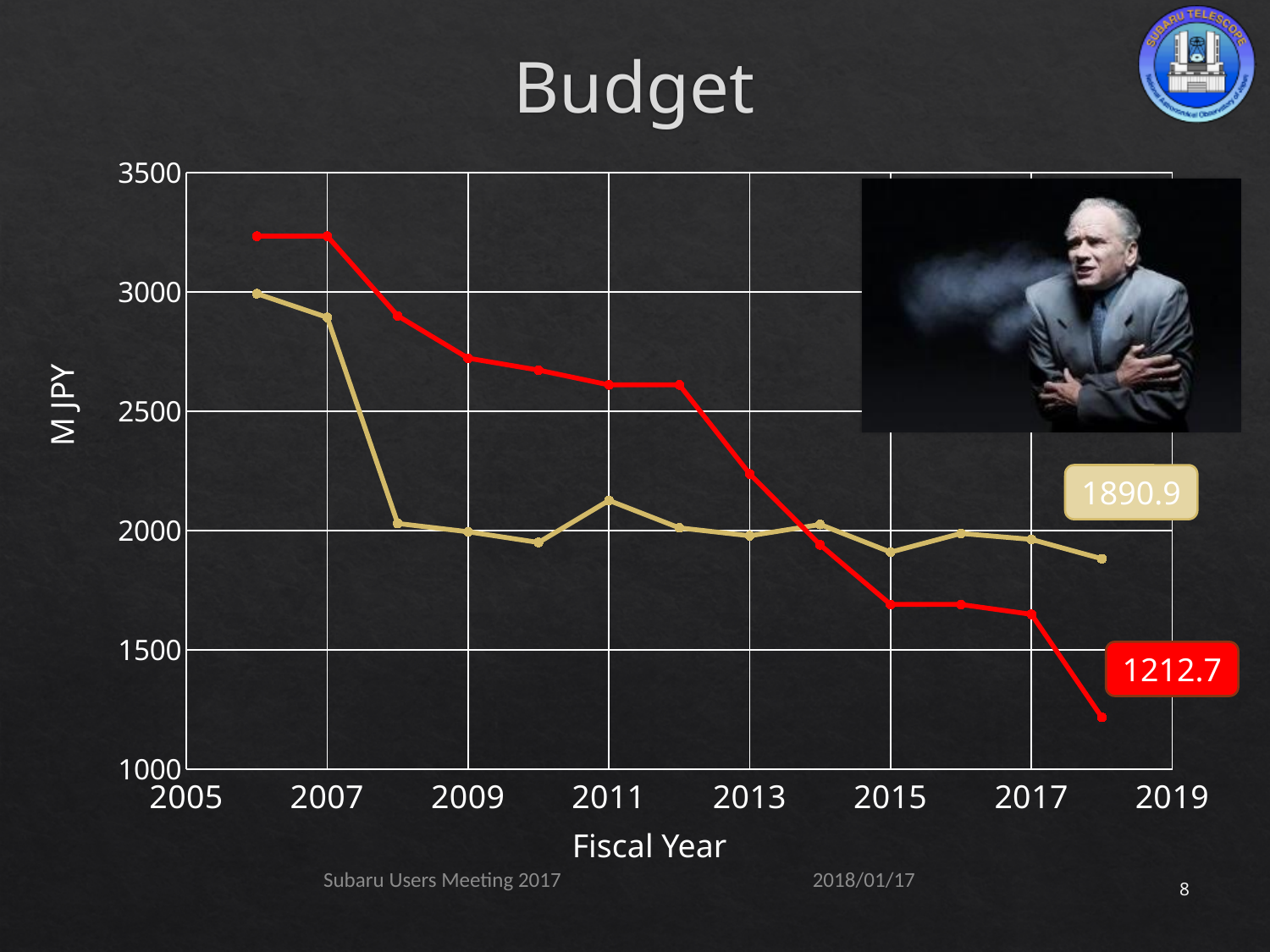
What is the label on the vertical axis of the chart? M JPY Is the value of the gold line in fiscal year 2015 greater or less than 2000? less Is the value of the red line in fiscal year 2006 greater or less than 3000? greater In fiscal year 2018, which line has the larger value, the red line or the gold line? the gold line Is the value of the red line in fiscal year 2015 greater or less than 1500? greater Does the red line generally rise or fall from 2006 to 2018? fall In fiscal year 2010, which line has the larger value, the red line or the gold line? the red line What is the difference between the two labelled 2018 values, 1890.9 and 1212.7? 678.2 What is the labelled value of the red line at fiscal year 2018? 1212.7 In which fiscal year does the red line reach its lowest value? 2018 What is the labelled value of the gold line at fiscal year 2018? 1890.9 What kind of chart is shown on the slide? line chart